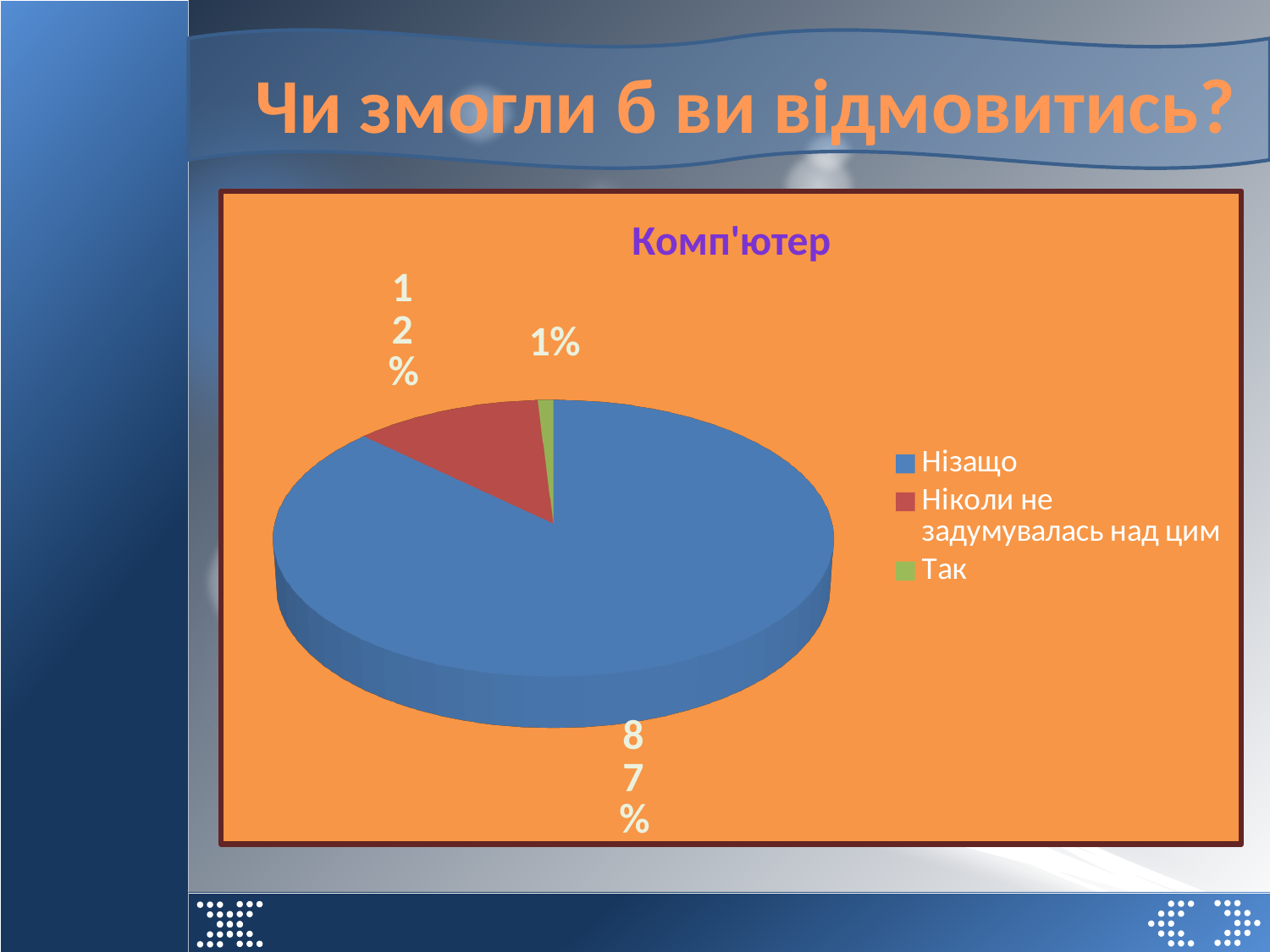
What is the title of the chart? Комп'ютер Which is larger, the 'Ніколи не задумувалась над цим' slice or the 'Так' slice? Ніколи не задумувалась над цим What share of the pie does the 'Ніколи не задумувалась над цим' slice represent? 12% What is the difference in percentage points between the 'Нізащо' slice and the 'Ніколи не задумувалась над цим' slice? 75 How many categories does the legend list? 3 What share of the pie does the 'Так' slice represent? 1% What type of chart is shown on the slide? pie chart Which category has the smallest slice of the pie? Так Which category has the largest slice of the pie? Нізащо What is the difference in percentage points between the 'Ніколи не задумувалась над цим' slice and the 'Так' slice? 11 What colour is the 'Так' slice in the pie chart? green What share of the pie does the 'Нізащо' slice represent? 87%